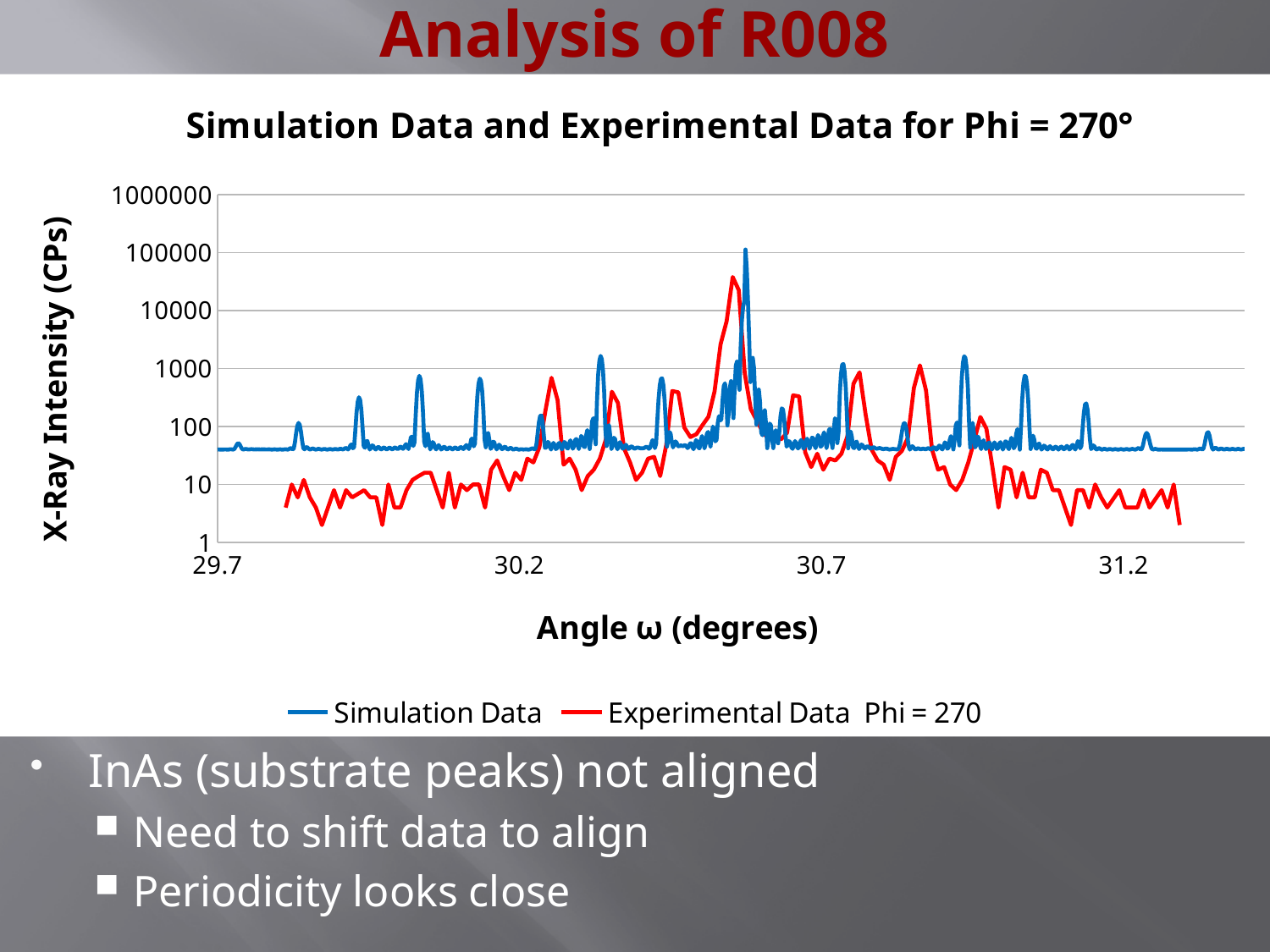
What is the title of the chart? Simulation Data and Experimental Data for Phi = 270° Which series is drawn in red? Experimental Data Phi = 270 What kind of chart is shown on the slide? Line chart Is the baseline level of the Simulation Data series between its peaks greater or less than 100? less Is the highest peak of the Experimental Data Phi = 270 series greater or less than 1000? greater Is the highest peak of the Simulation Data series greater or less than 10000? greater Which series reaches the higher maximum intensity, Simulation Data or Experimental Data Phi = 270? Simulation Data What is the label of the y-axis? X-Ray Intensity (CPs) How many series does the chart's legend list? 2